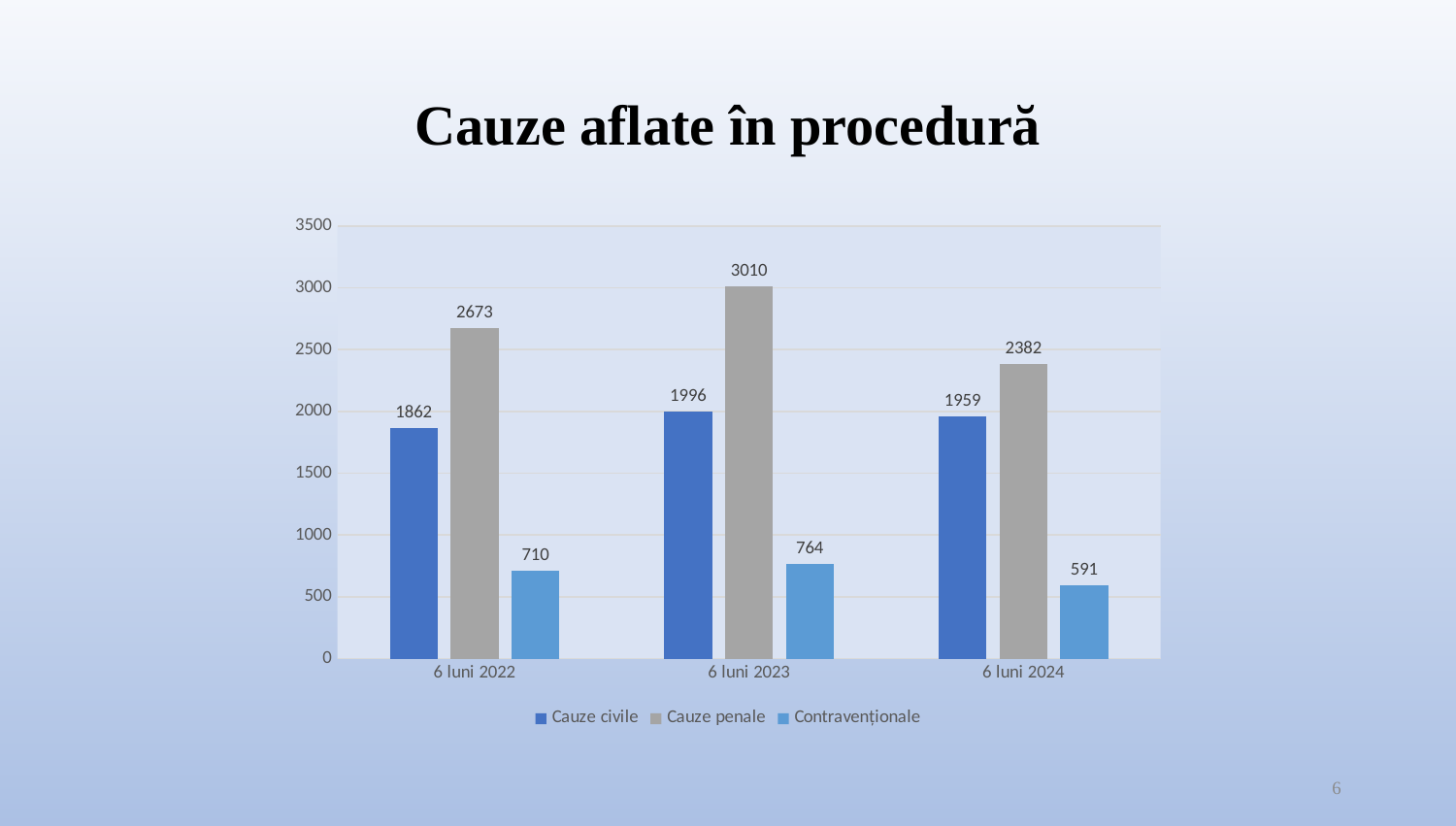
Which is larger: Cauze civile in 6 luni 2023 or Cauze civile in 6 luni 2024? 6 luni 2023 What is the title of the chart? Cauze aflate în procedură How many periods are shown on the x axis? 3 Is the value for Cauze penale in 6 luni 2022 greater or less than 2500? greater What kind of chart is shown on the slide? bar chart How many series does the legend list? 3 What is the value for Cauze penale in 6 luni 2023? 3010 What is the value for Cauze civile in 6 luni 2022? 1862 In which period is the value for Cauze penale highest? 6 luni 2023 What is the difference between Cauze penale in 6 luni 2023 and 6 luni 2024? 628 What is the value for Contravenționale in 6 luni 2024? 591 In which period is the value for Contravenționale lowest? 6 luni 2024